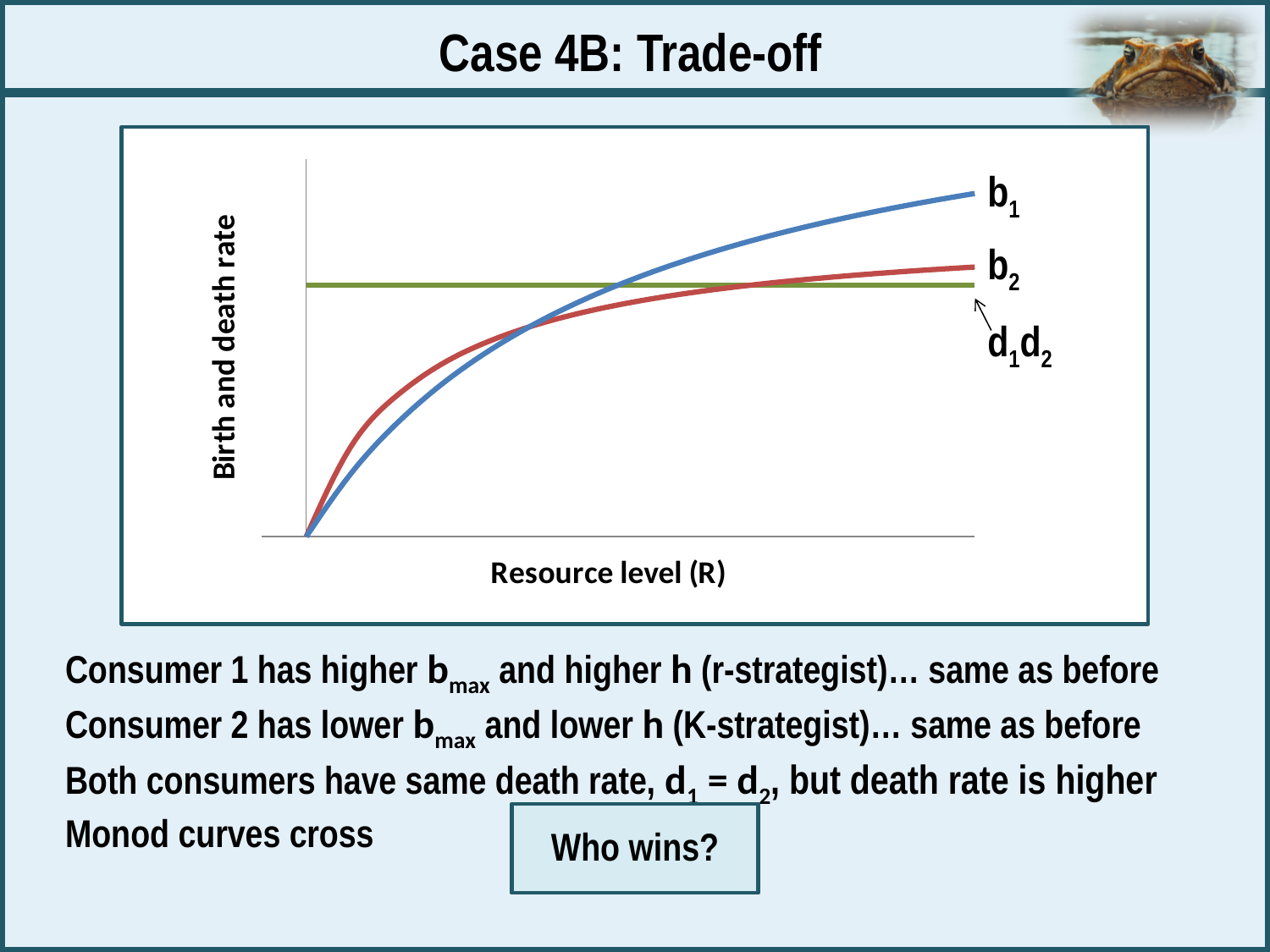
What is the label of the x axis of the chart? Resource level (R) Does the b2 curve rise or fall as resource level (R) increases? Rises Does the b1 curve rise or fall as resource level (R) increases? Rises Which curve reaches the highest value at the right end of the chart? b1 At the highest resource level shown, which curve is higher, b1 or b2? b1 Do the b1 and b2 curves cross each other on the chart? Yes What is the label of the y axis of the chart? Birth and death rate Which line on the chart stays flat across all resource levels? d1d2 At low resource levels near the origin, which curve is higher, b1 or b2? b2 How many lines are plotted on the chart? 3 What kind of chart is shown on the slide? Line chart